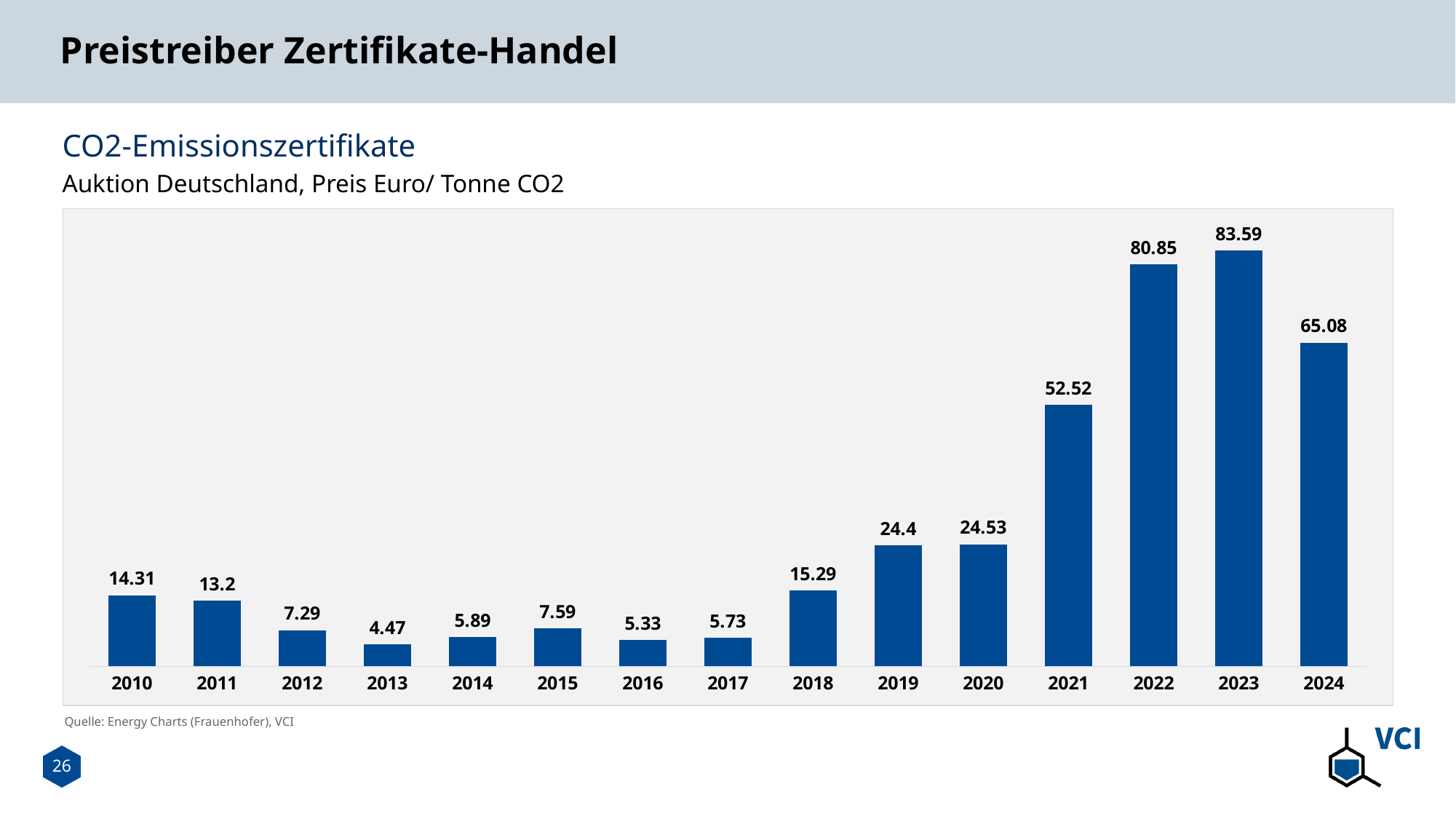
What is the difference between the values for 2023 and 2024? 18.51 Which year has the lowest value in the chart? 2013 What is the title of the chart? CO2-Emissionszertifikate What is the value shown for 2013? 4.47 What is the CO2 certificate price shown for 2021? 52.52 Which year has the larger value, 2010 or 2018? 2018 What is the value shown for 2024? 65.08 Do the values rise or fall from 2020 to 2023? Rise Which year has the highest value in the chart? 2023 How many years are shown on the x axis of the chart? 15 What kind of chart is shown on the slide? Bar chart What is the difference between the values for 2022 and 2021? 28.33